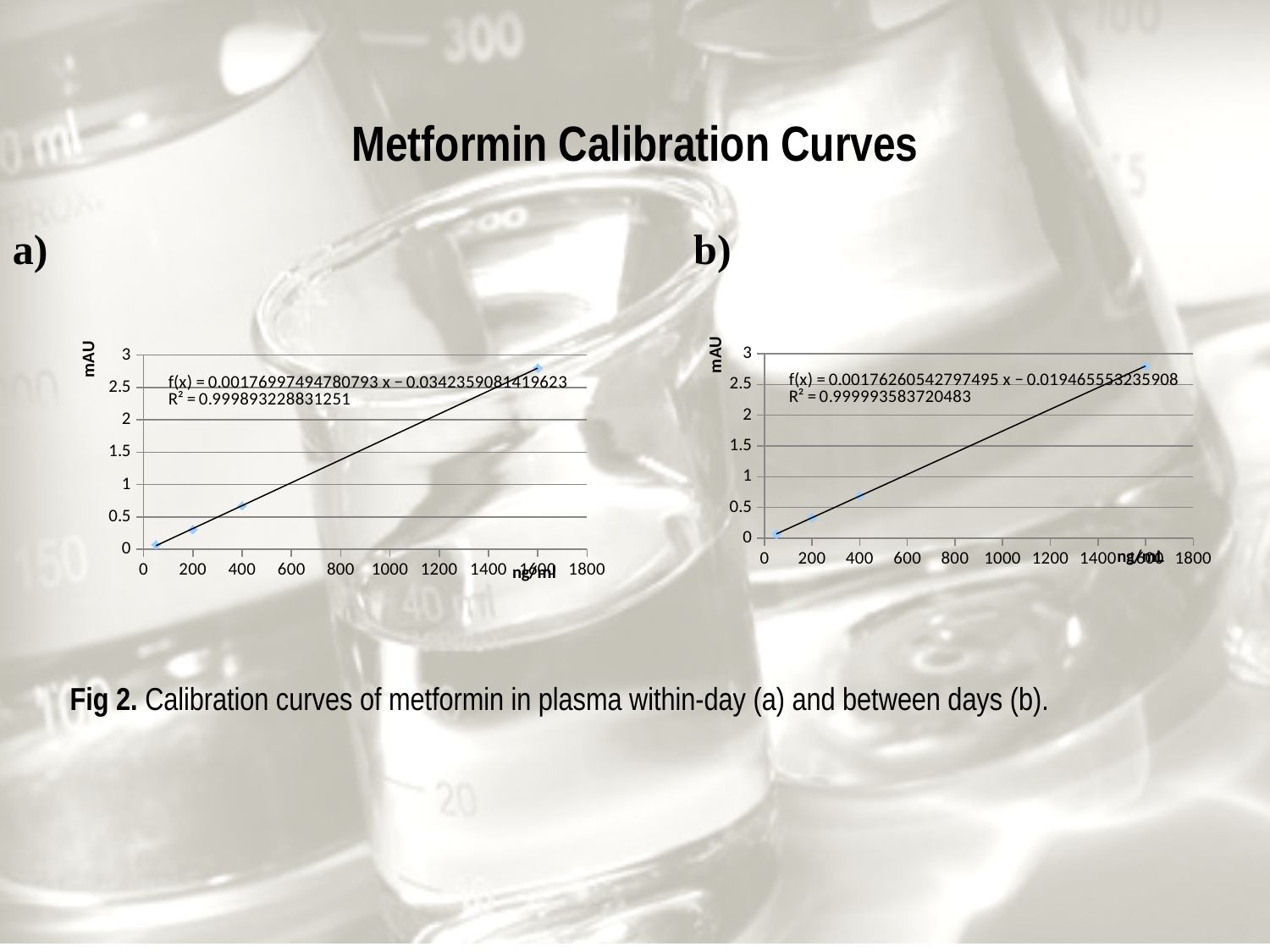
How many data points are plotted in chart b)? 4 In chart a), is the mAU value at 1600 ng/ml greater or less than 2.5? greater How many data points are plotted in chart a)? 4 What kind of chart is chart a)? scatter chart What is the R² value printed on chart b)? 0.999993583720483 In chart a), do the mAU values rise or fall as ng/ml increases? rise In chart a), which has the higher mAU value: the point at 400 ng/ml or the point at 1600 ng/ml? 1600 ng/ml In chart a), is the mAU value at 400 ng/ml greater or less than 1? less In chart b), do the mAU values rise or fall as ng/ml increases? rise In chart b), is the mAU value at 200 ng/ml greater or less than 0.5? less What is the y-axis label of chart a)? mAU